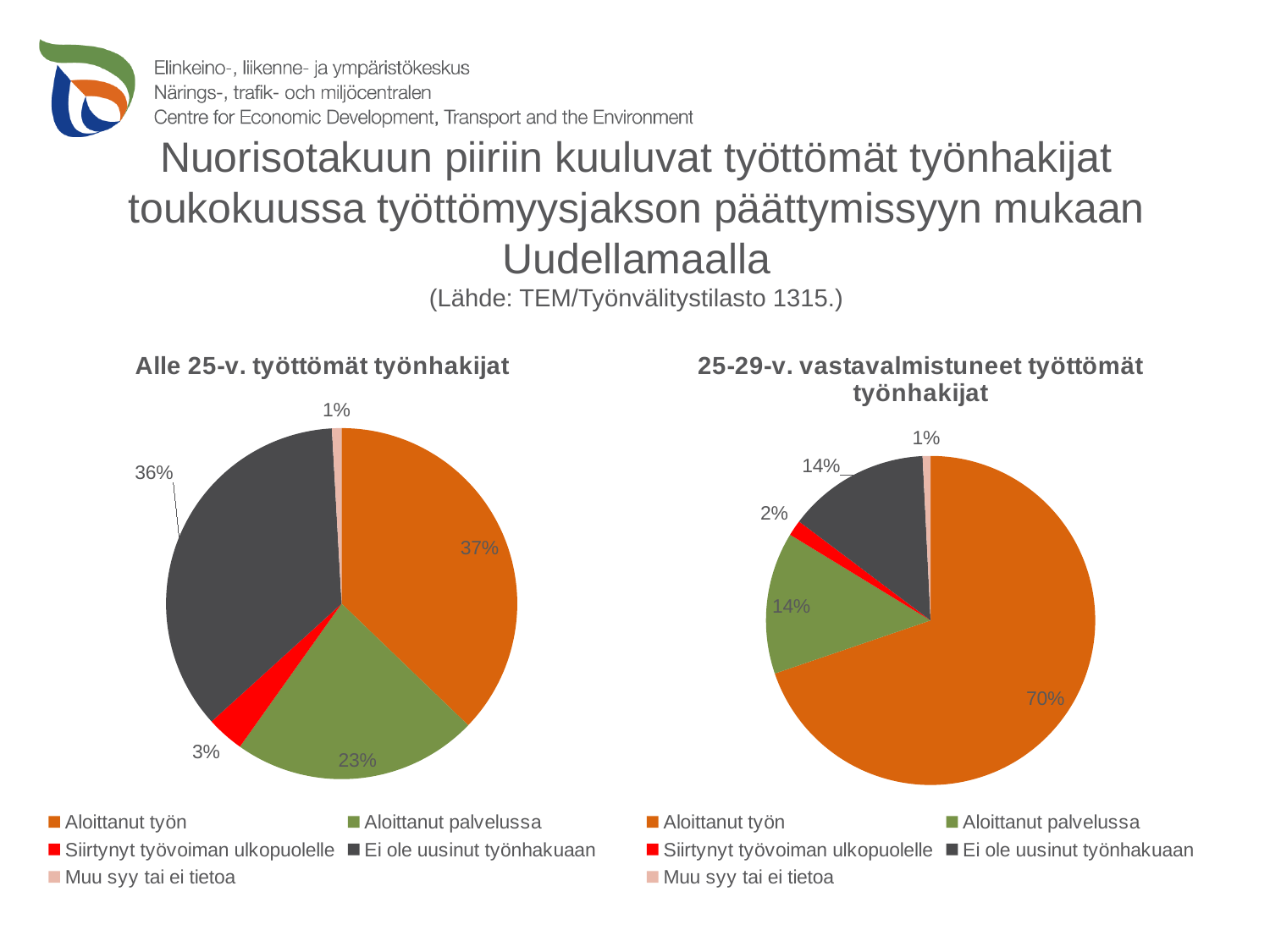
In the '25-29-v. vastavalmistuneet työttömät työnhakijat' chart, what share is 'Siirtynyt työvoiman ulkopuolelle'? 2% In the 'Alle 25-v. työttömät työnhakijat' chart, what share is 'Siirtynyt työvoiman ulkopuolelle'? 3% In the 'Alle 25-v. työttömät työnhakijat' chart, which category has the smallest share? Muu syy tai ei tietoa In the 'Alle 25-v. työttömät työnhakijat' chart, what is the difference between 'Aloittanut työn' and 'Aloittanut palvelussa'? 14 percentage points In the 'Alle 25-v. työttömät työnhakijat' chart, what share is 'Ei ole uusinut työnhakuaan'? 36% In the '25-29-v. vastavalmistuneet työttömät työnhakijat' chart, what share is 'Aloittanut työn'? 70% Which chart has the larger share for 'Aloittanut työn', the left one or the right one? the right one (25-29-v. vastavalmistuneet työttömät työnhakijat) In the 'Alle 25-v. työttömät työnhakijat' chart, what share is 'Aloittanut työn'? 37% In the '25-29-v. vastavalmistuneet työttömät työnhakijat' chart, what colour is the 'Aloittanut palvelussa' slice? green How many categories does the legend of the '25-29-v. vastavalmistuneet työttömät työnhakijat' chart list? 5 What kind of chart is the 'Alle 25-v. työttömät työnhakijat' chart? pie chart In the '25-29-v. vastavalmistuneet työttömät työnhakijat' chart, which category has the largest share? Aloittanut työn